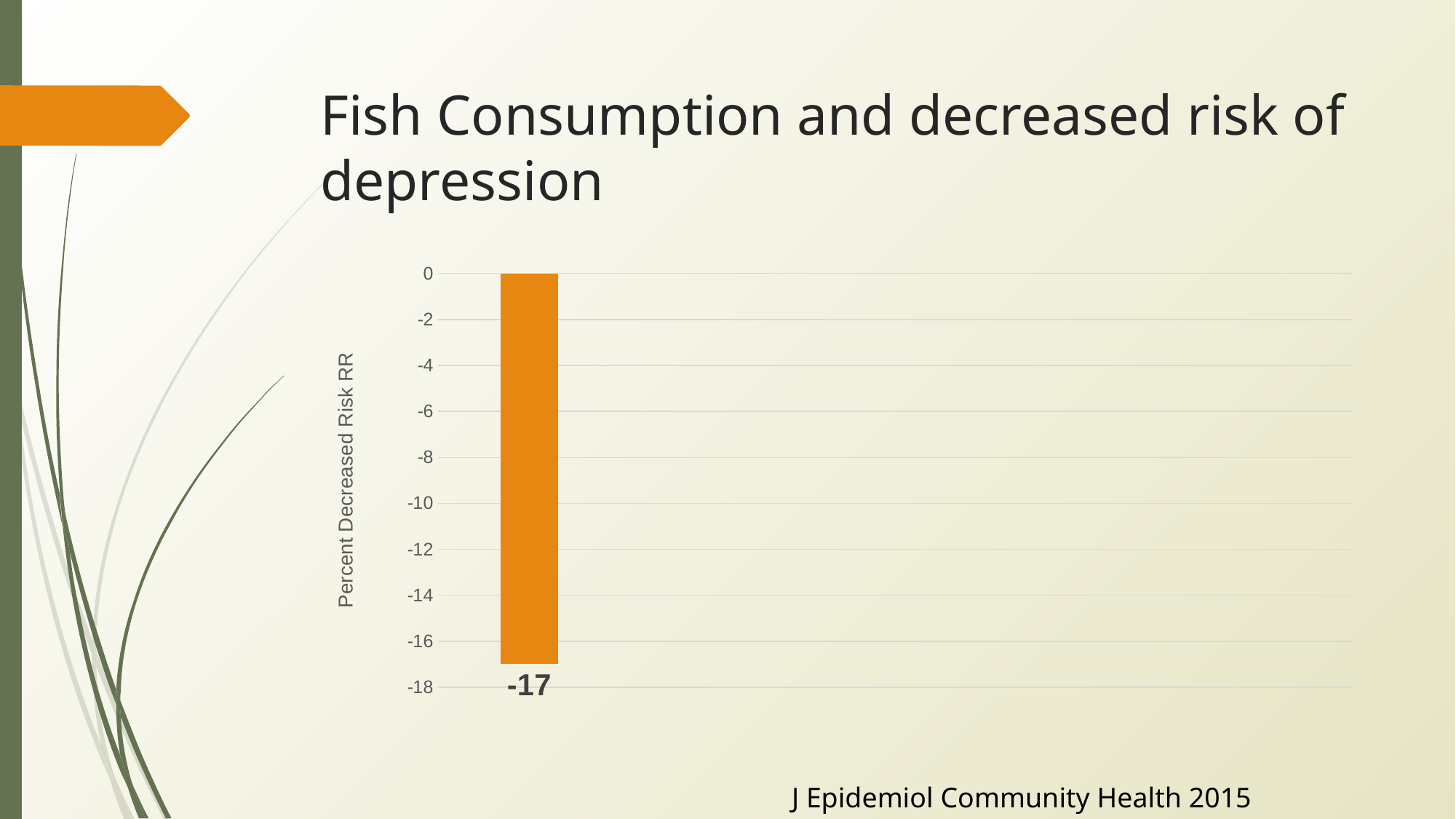
What is the lowest value shown on the vertical axis? -18 What value is shown by the single bar on the chart? -17 Is the value of the bar greater or less than -10? less Is the value of the bar greater or less than -18? greater How many bars are plotted on the chart? 1 What kind of chart is shown on the slide? bar chart What is the label of the vertical axis? Percent Decreased Risk RR